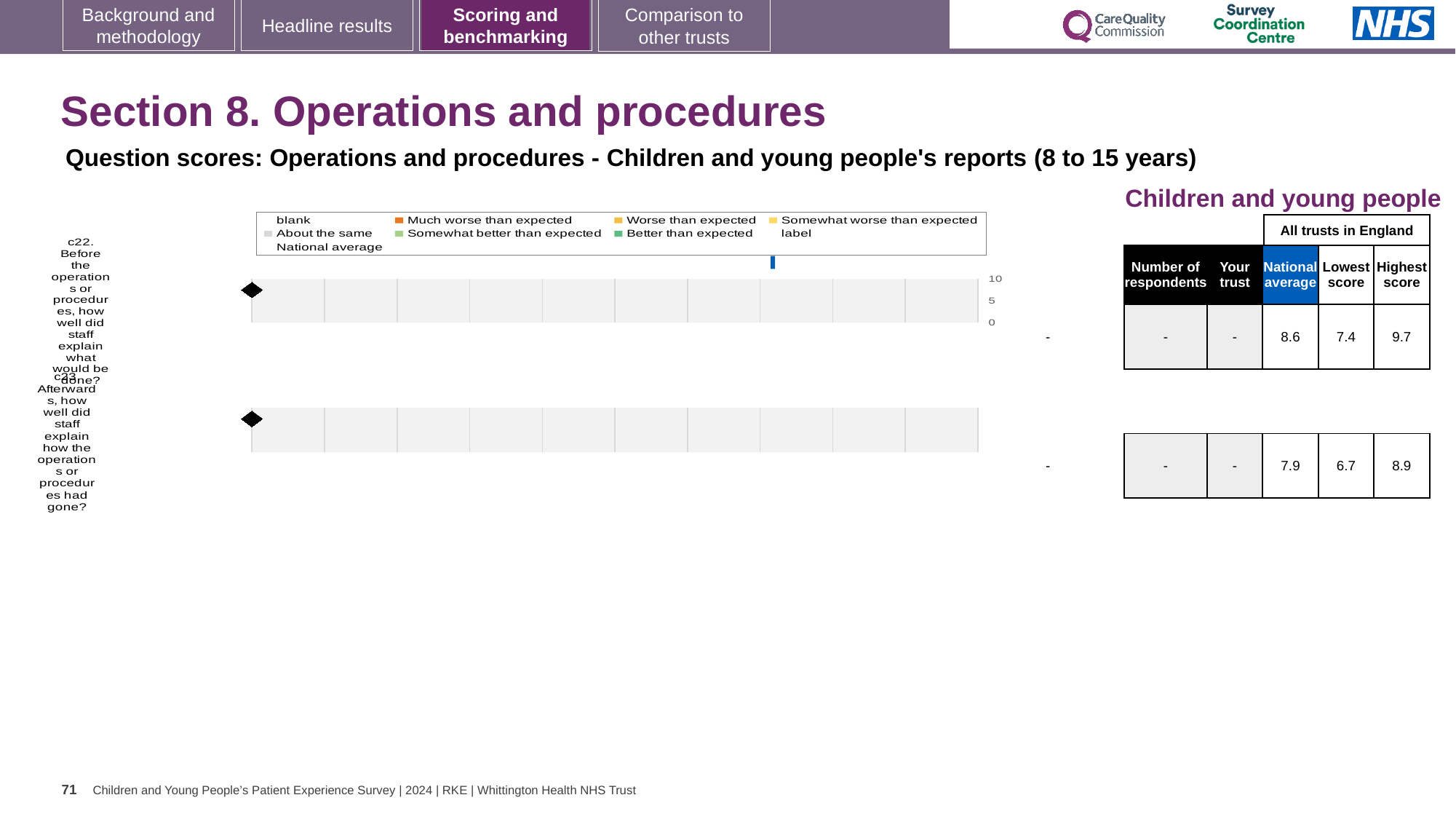
How many entries does the chart legend list? 9 In the table next to the chart, what is the national average for c23 (Afterwards, how well did staff explain how the operations or procedures had gone)? 7.9 What kind of chart is shown on the slide? Bar chart In the table next to the chart, what is the national average for c22 (Before the operations or procedures, how well did staff explain what would be done)? 8.6 In the table next to the chart, what is the highest score for c22? 9.7 In the table next to the chart, which question has the higher national average, c22 or c23? c22 How many question categories are plotted on the chart? 2 Which question code is the first category on the chart? c22 What is the title of the chart section shown on the slide? Question scores: Operations and procedures - Children and young people's reports (8 to 15 years) In the table next to the chart, what is the difference between the highest and lowest score for c23? 2.2 What is the highest tick value shown on the chart's axis? 10 In the table next to the chart, what is the lowest score for c23? 6.7